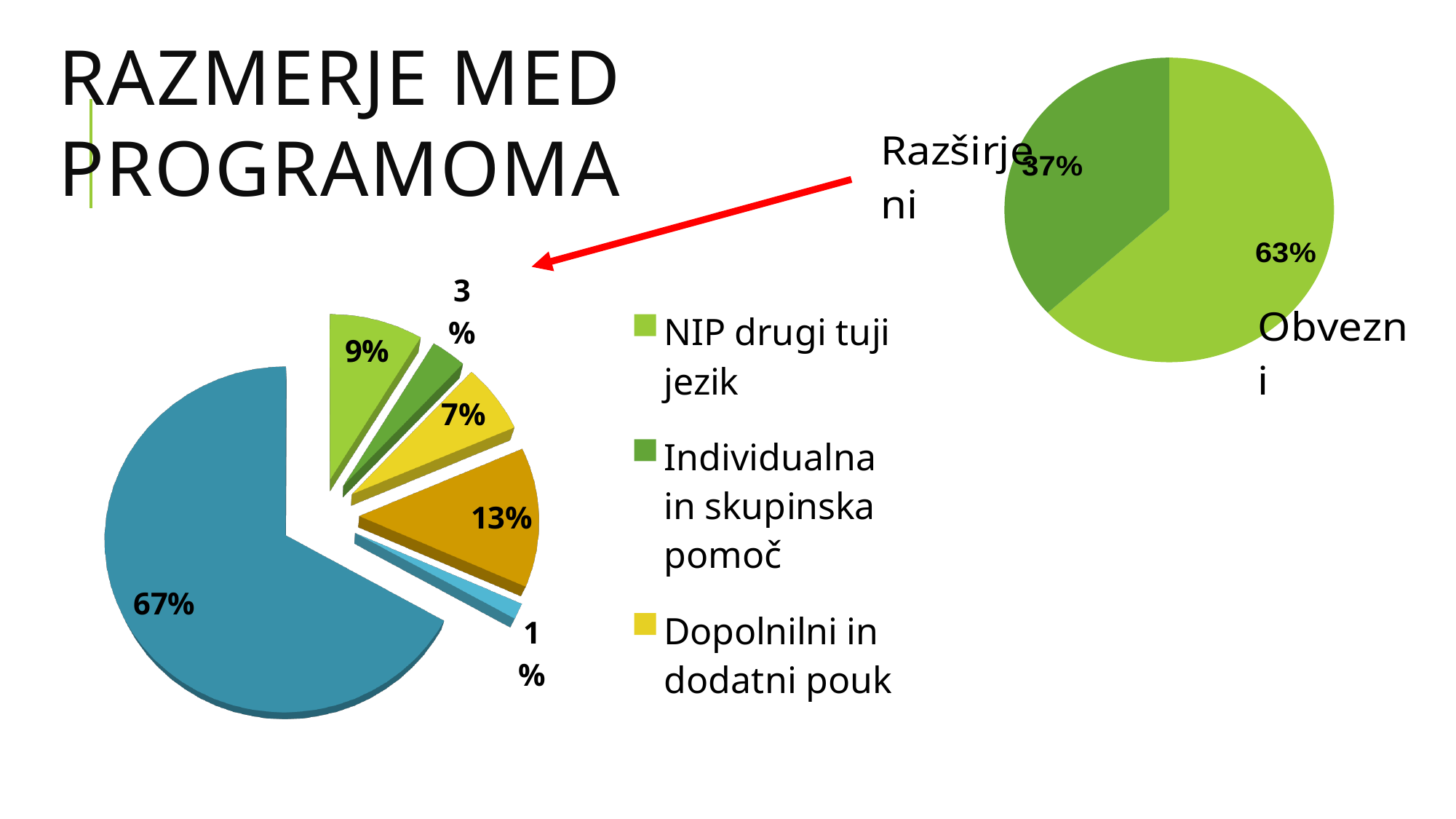
In the top-right pie chart, what share is labelled for Obvezni? 63% In the bottom-left pie chart, what share is labelled for Individualna in skupinska pomoč? 3% In the bottom-left pie chart, what share is labelled for NIP drugi tuji jezik? 9% How many slices does the bottom-left pie chart have? 6 In the top-right pie chart, what share is labelled for Razširjeni? 37% How many slices does the top-right pie chart have? 2 What kind of chart is the bottom-left chart? pie chart In the top-right pie chart, what is the difference in percentage points between Obvezni and Razširjeni? 26 In the bottom-left pie chart, what share is labelled for Dopolnilni in dodatni pouk? 7% In the top-right pie chart, which slice is larger, Obvezni or Razširjeni? Obvezni In the bottom-left pie chart, what is the largest percentage label shown? 67% How many entries does the legend next to the bottom-left pie chart list? 3